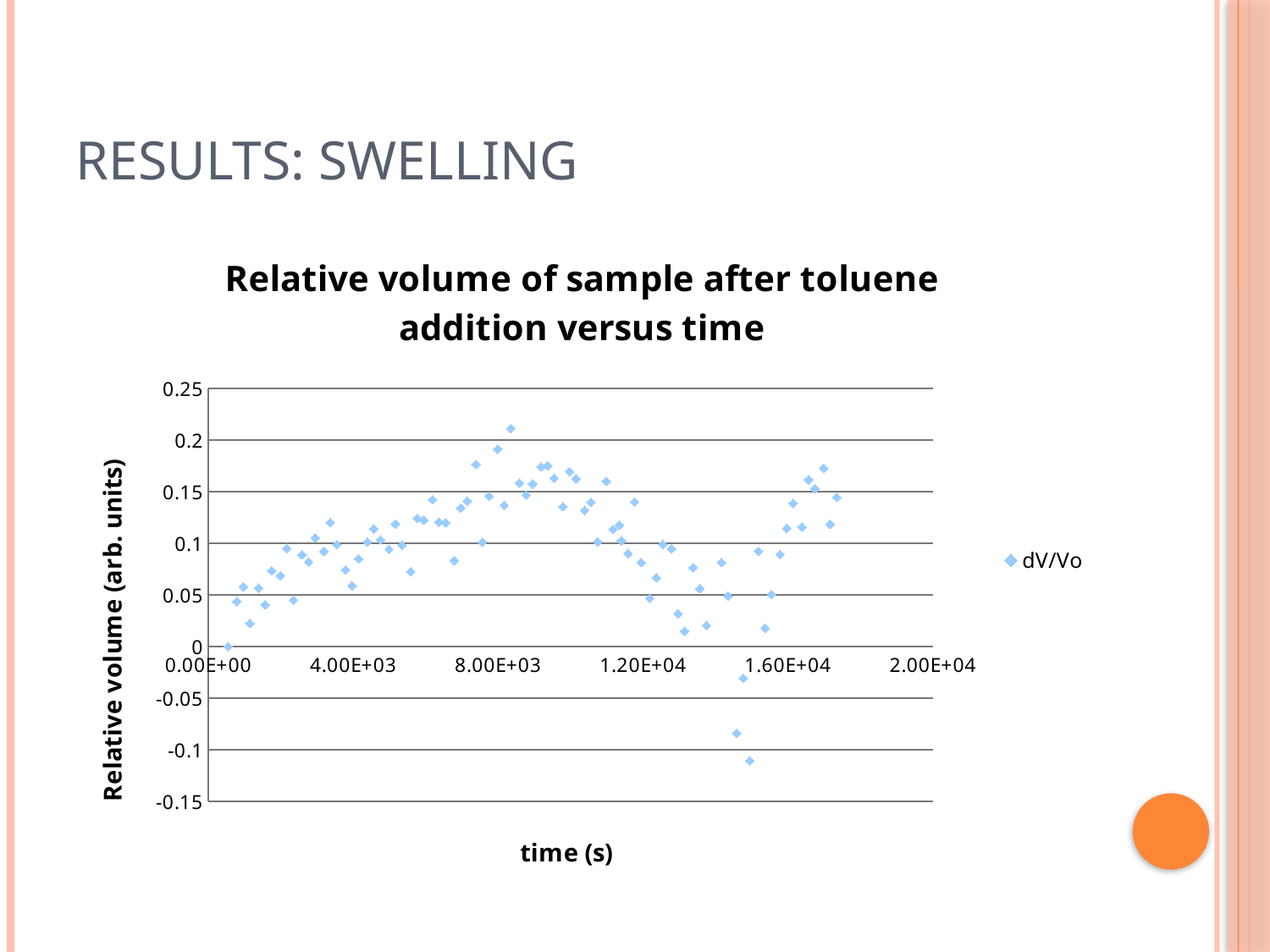
What is the name of the series shown in the legend? dV/Vo Is the lowest plotted value of dV/Vo greater or less than -0.05? less How many series does the legend list? 1 Do the dV/Vo values generally rise or fall between time 1.20E+04 and 1.50E+04 s? fall What is the title of the chart? Relative volume of sample after toluene addition versus time What kind of chart is shown on the slide? scatter chart Is the highest plotted value of dV/Vo greater or less than 0.15? greater Do the dV/Vo values generally rise or fall between time 0.00E+00 and 8.00E+03 s? rise